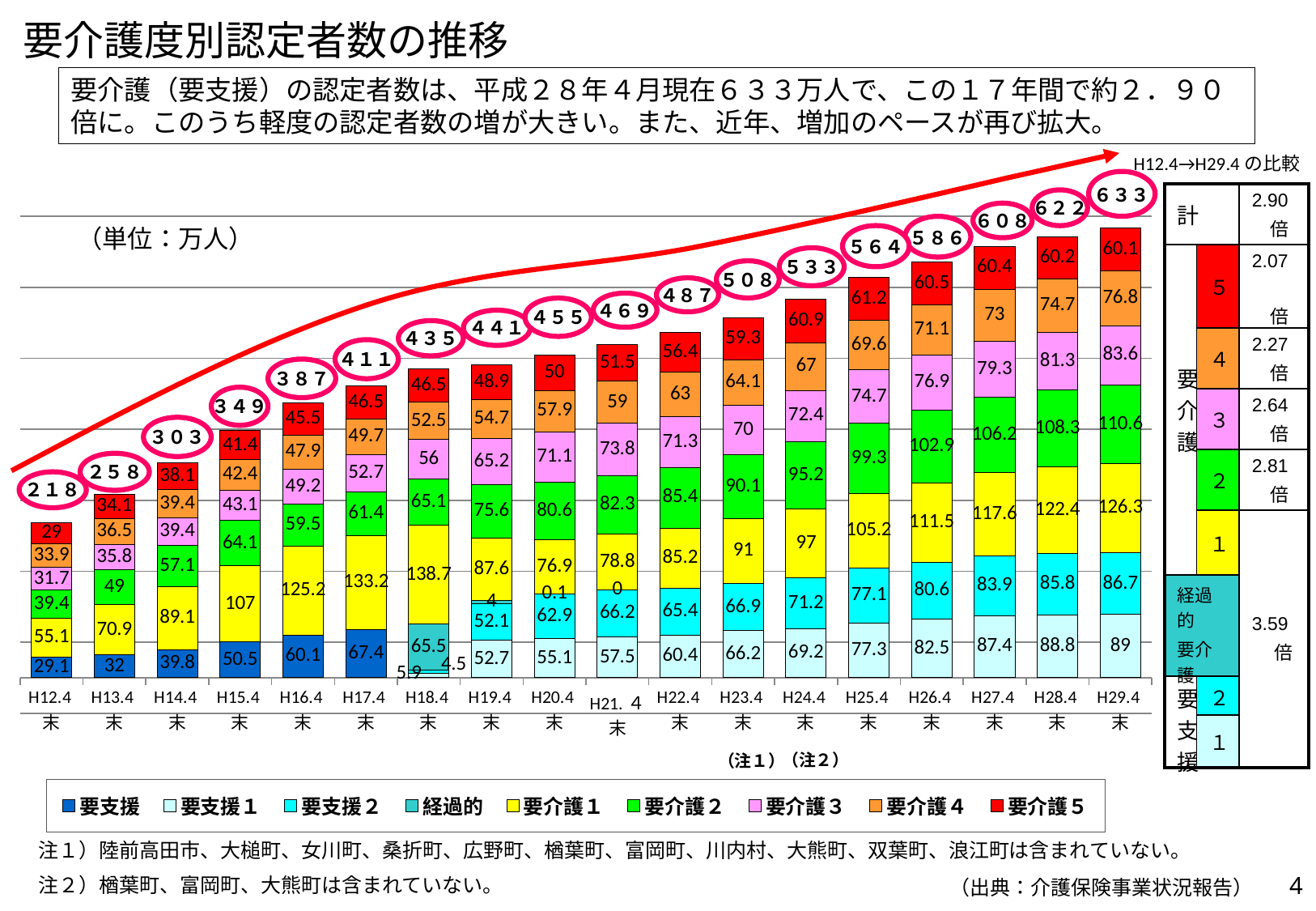
How many time points (bars) are plotted along the x axis? 18 What is the difference between the total for H29.4末 and the total for H12.4末? 415 What is the total of the stacked bar for H29.4末? 633 What is the value for 要支援1 at H29.4末? 89 What kind of chart is shown on the slide? stacked bar chart Do the bar totals rise or fall from H12.4 to H29.4? rise Which is larger at H29.4末, 要介護1 or 要介護2? 要介護1 How many series does the legend list? 9 What is the value for 要介護1 at H18.4末? 138.7 What is the total of the stacked bar for H12.4末? 218 Which time point has the highest total number of certified persons? H29.4末 What is the value for 要介護5 at H29.4末? 60.1